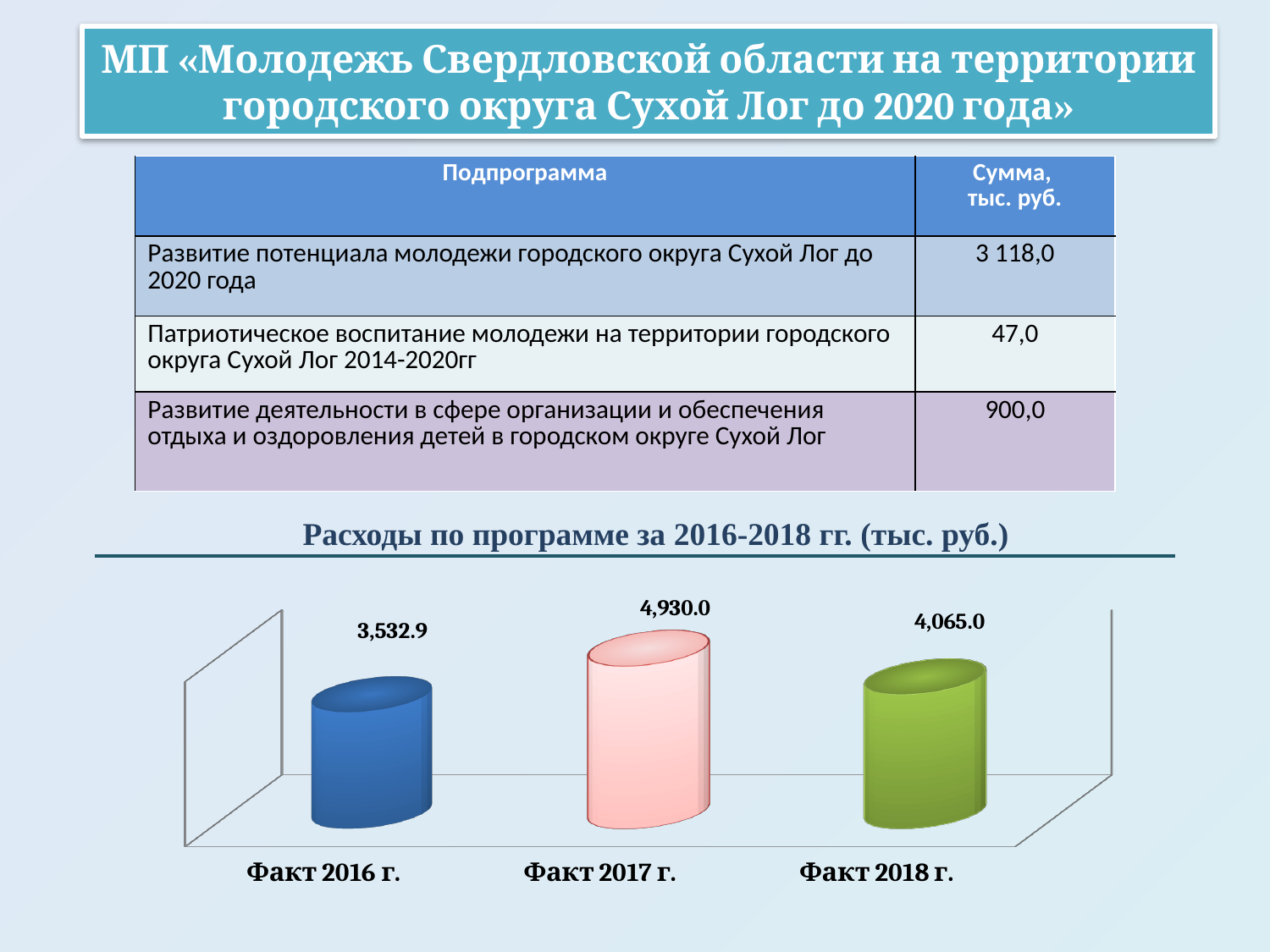
Which is larger, the value for Факт 2018 г. or Факт 2016 г.? Факт 2018 г. Do the values rise or fall from Факт 2017 г. to Факт 2018 г.? Fall Which category has the highest value? Факт 2017 г. How many categories are shown in the chart? 3 What kind of chart is shown on the slide? Bar chart What is the title of the chart? Расходы по программе за 2016-2018 гг. (тыс. руб.) What is the value for Факт 2017 г.? 4,930.0 What is the difference between the values for Факт 2017 г. and Факт 2016 г.? 1,397.1 What is the difference between the values for Факт 2017 г. and Факт 2018 г.? 865.0 What is the value for Факт 2018 г.? 4,065.0 Which category has the lowest value? Факт 2016 г. What is the value for Факт 2016 г.? 3,532.9